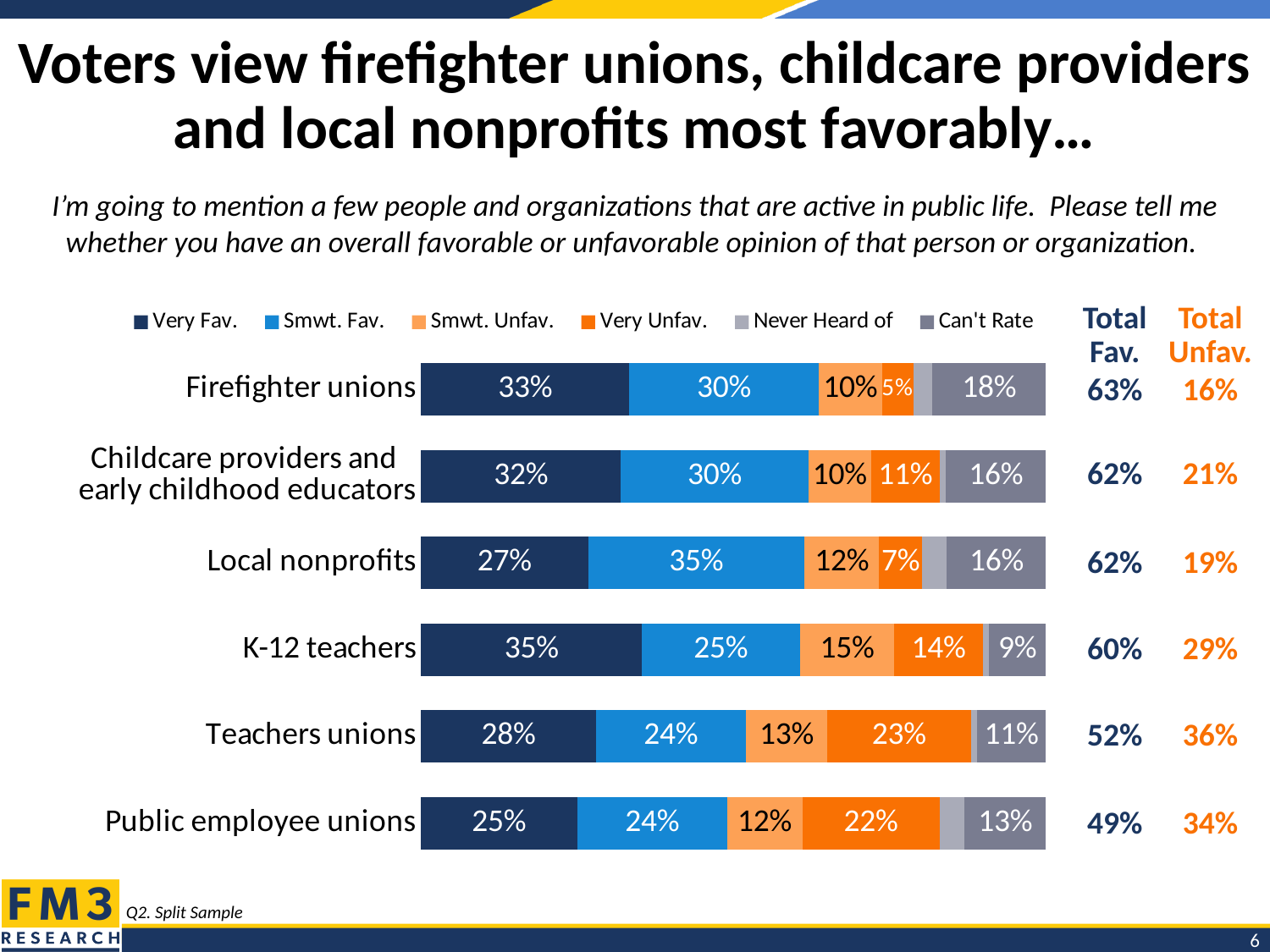
What is the Total Unfav. value shown for K-12 teachers? 29% What is the Very Fav. value for Firefighter unions? 33% What is the Smwt. Fav. value for Local nonprofits? 35% How many series does the legend list? 6 Which category has the highest Very Fav. value? K-12 teachers What kind of chart is shown on the slide? Stacked bar chart What is the Very Unfav. value for Teachers unions? 23% What is the difference between the Very Fav. value for K-12 teachers and the Very Fav. value for Public employee unions? 10 percentage points Which has a larger Smwt. Unfav. value, K-12 teachers or Teachers unions? K-12 teachers Which category has the lowest Total Fav. value? Public employee unions Which category has the highest Total Unfav. value? Teachers unions How many categories (organizations) are shown in the chart? 6